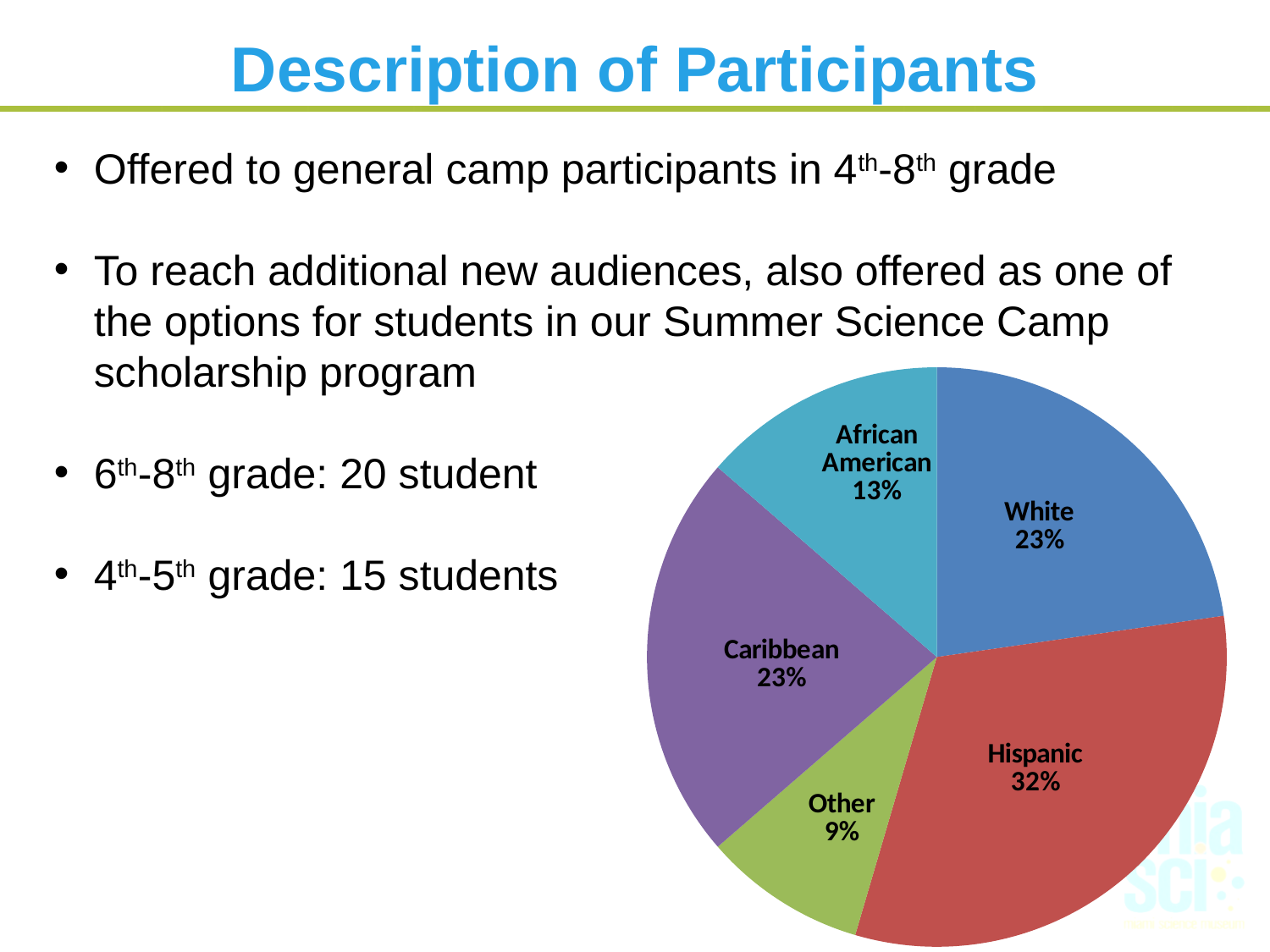
What is the difference between the African American and Other percentages? 4% Which category has the largest slice of the pie? Hispanic What is the value shown for Other? 9% Which category has the smallest slice of the pie? Other What is the value shown for African American? 13% What share of the pie does Hispanic represent? 32% What colour is the Hispanic slice of the pie? red What is the difference between the Hispanic and White percentages? 9% What is the value shown for Caribbean? 23% What kind of chart is shown on the slide? pie chart Which is larger, the African American slice or the Caribbean slice? Caribbean How many slices does the pie chart have? 5